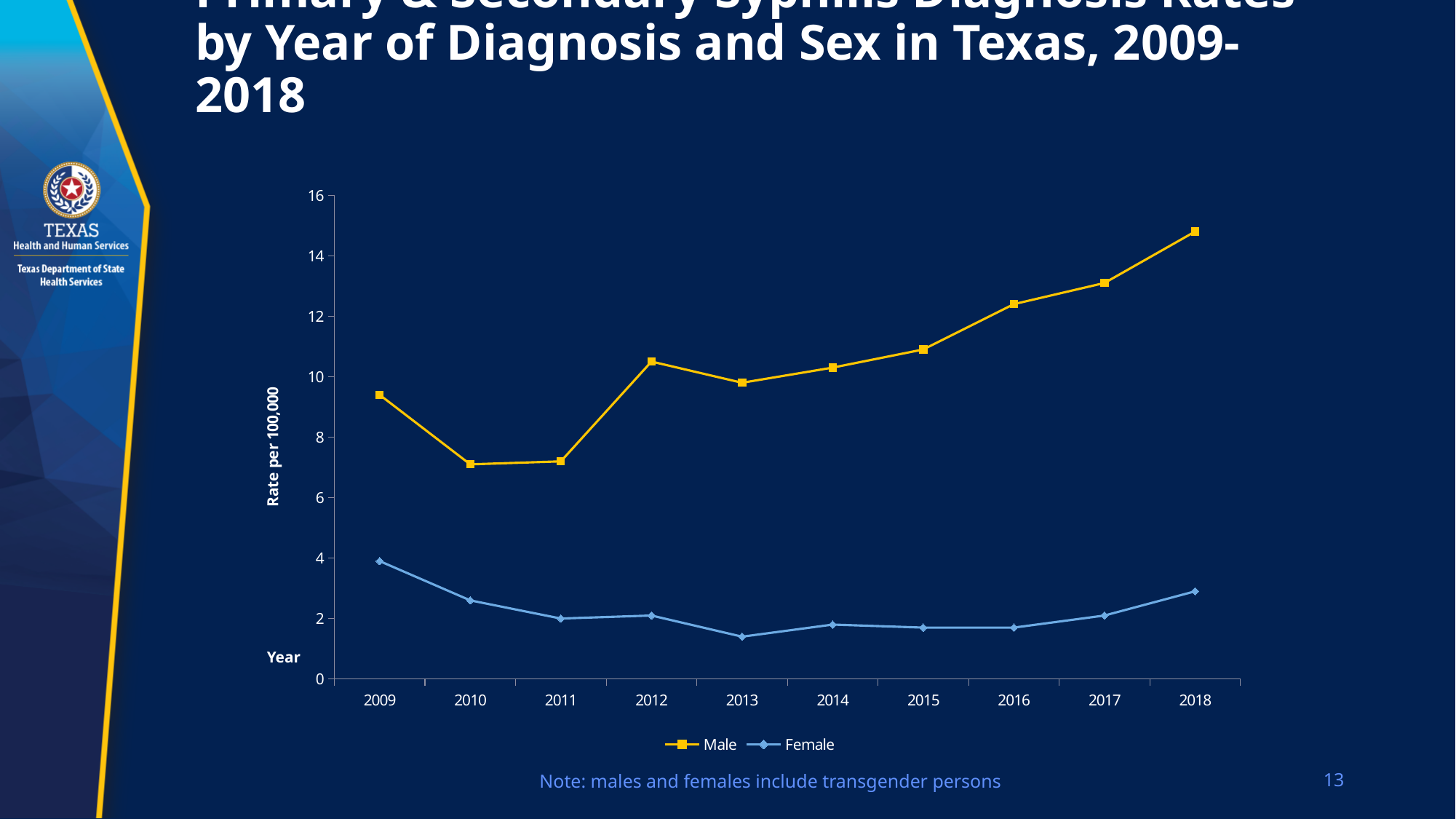
In which year is the Female rate highest? 2009 How many series does the legend list? 2 What kind of chart is shown on the slide? line chart In which year is the Male rate highest? 2018 Does the Male rate rise or fall from 2013 to 2018? rise Which is larger, the Male rate in 2012 or the Male rate in 2009? 2012 Is the Female rate in 2013 greater or less than 2? less Is the Male rate in 2010 greater or less than 8? less Is the Male rate in 2018 greater or less than 14? greater How many years are plotted along the x axis? 10 What is the label on the y axis? Rate per 100,000